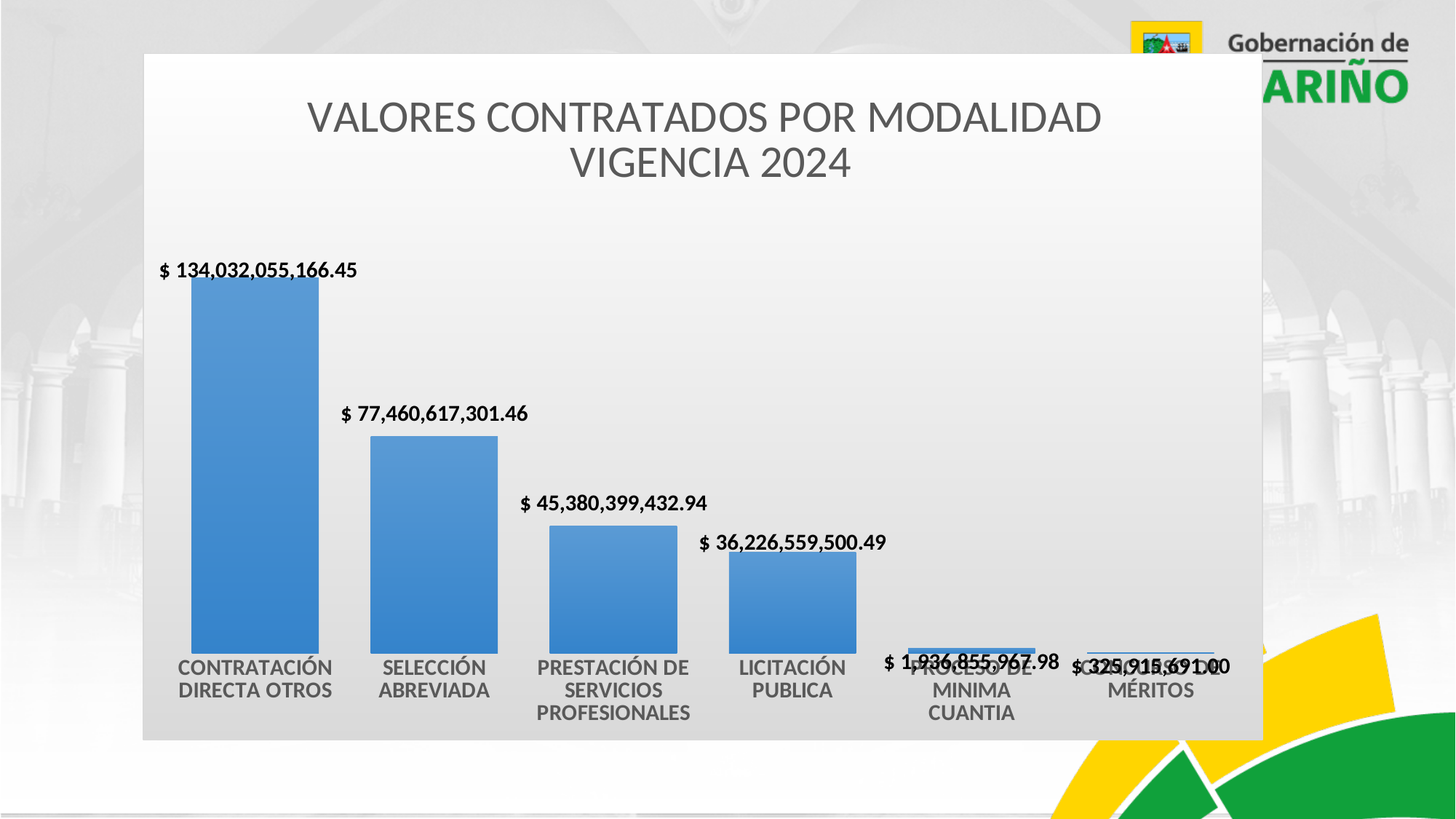
How many modalities are shown in the chart? 6 What is the difference between the values for PRESTACIÓN DE SERVICIOS PROFESIONALES and LICITACIÓN PUBLICA? $ 9,153,839,932.45 Which modality has the lowest contracted value? CONCURSO DE MÉRITOS What is the value for PRESTACIÓN DE SERVICIOS PROFESIONALES? $ 45,380,399,432.94 What kind of chart is shown on the slide? Bar chart Which modality has the highest contracted value? CONTRATACIÓN DIRECTA OTROS What is the value for PROCESO DE MINIMA CUANTIA? $ 1,936,855,967.98 What is the difference between the values for CONTRATACIÓN DIRECTA OTROS and SELECCIÓN ABREVIADA? $ 56,571,437,864.99 What is the value for SELECCIÓN ABREVIADA? $ 77,460,617,301.46 What is the value for LICITACIÓN PUBLICA? $ 36,226,559,500.49 What is the value for CONTRATACIÓN DIRECTA OTROS? $ 134,032,055,166.45 Which is larger, the value for SELECCIÓN ABREVIADA or the value for LICITACIÓN PUBLICA? SELECCIÓN ABREVIADA